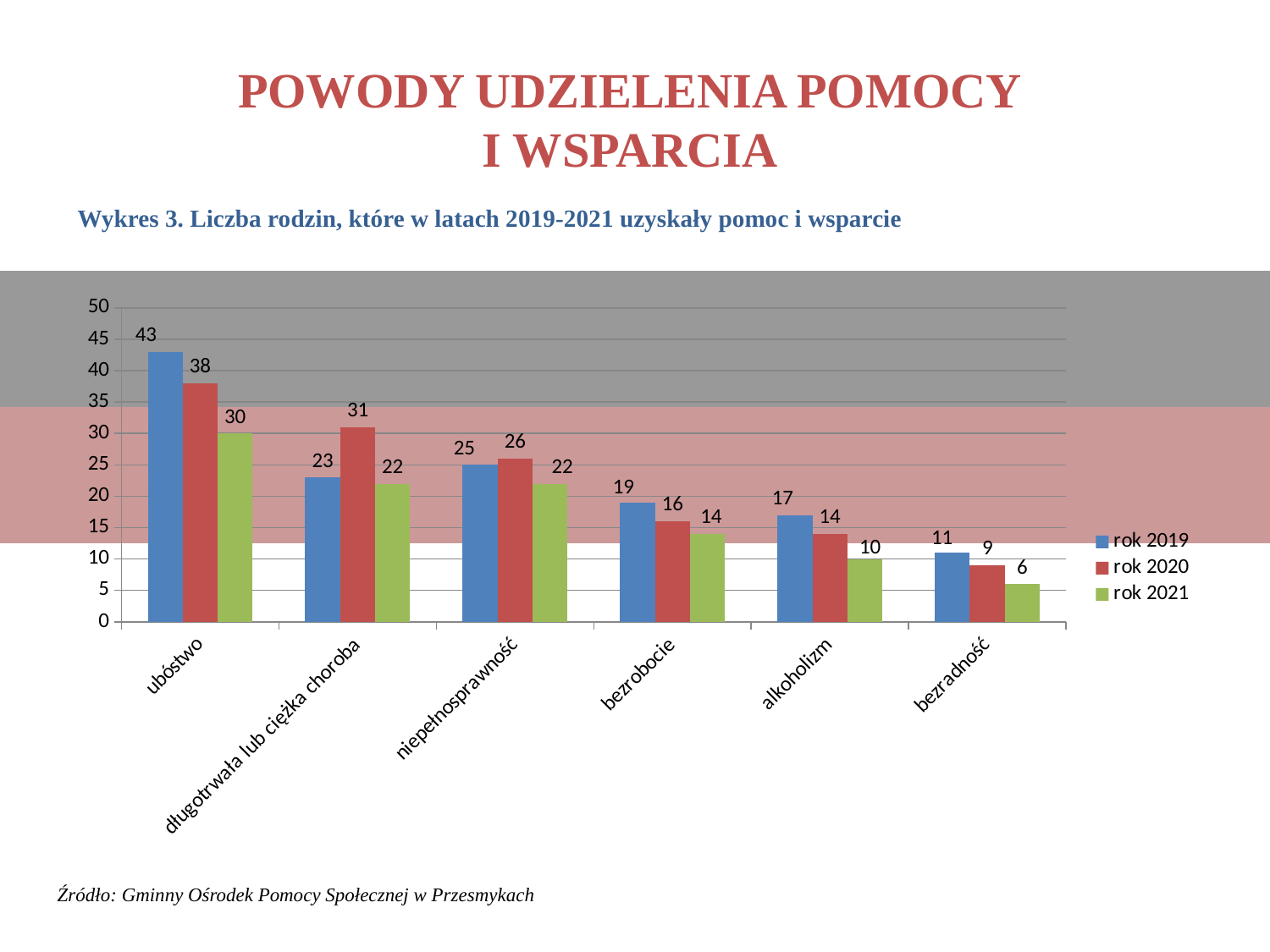
What is the title of the chart (Wykres 3)? Liczba rodzin, które w latach 2019-2021 uzyskały pomoc i wsparcie Which category has the lowest value in rok 2021? bezradność What is the value for długotrwała lub ciężka choroba in rok 2020? 31 What is the difference between the rok 2019 and rok 2021 values for ubóstwo? 13 Do the rok 2021 values rise or fall from ubóstwo to bezradność? fall What is the value for bezradność in rok 2021? 6 Which category has the highest value in rok 2019? ubóstwo How many series does the legend list? 3 How many categories are shown on the x axis? 6 Which is larger for niepełnosprawność: the rok 2019 value or the rok 2020 value? rok 2020 What kind of chart is shown on the slide? bar chart What is the value for ubóstwo in rok 2019? 43